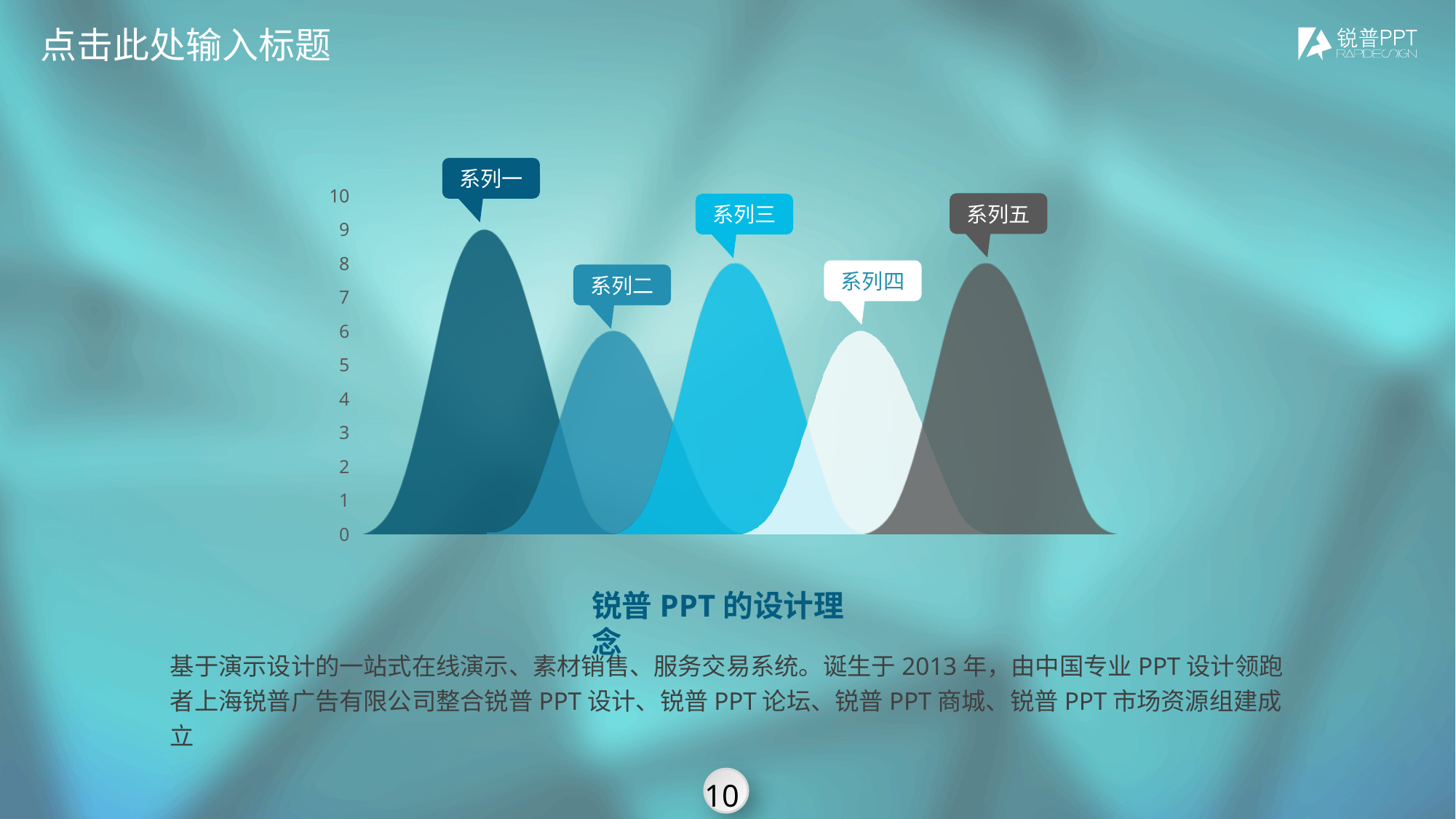
Which series is drawn in the lightest (near-white) colour on the chart? 系列四 Which has the higher peak, 系列三 or 系列四? 系列三 What kind of chart is shown on the slide? area chart Is the peak value for 系列一 greater or less than 8? greater Is the peak value for 系列三 greater or less than 7? greater What is the highest value shown on the vertical axis of the chart? 10 Is the peak value for 系列五 greater or less than 7? greater Which has the higher peak, 系列一 or 系列二? 系列一 How many series are labelled on the chart? 5 Which series reaches the highest peak on the chart? 系列一